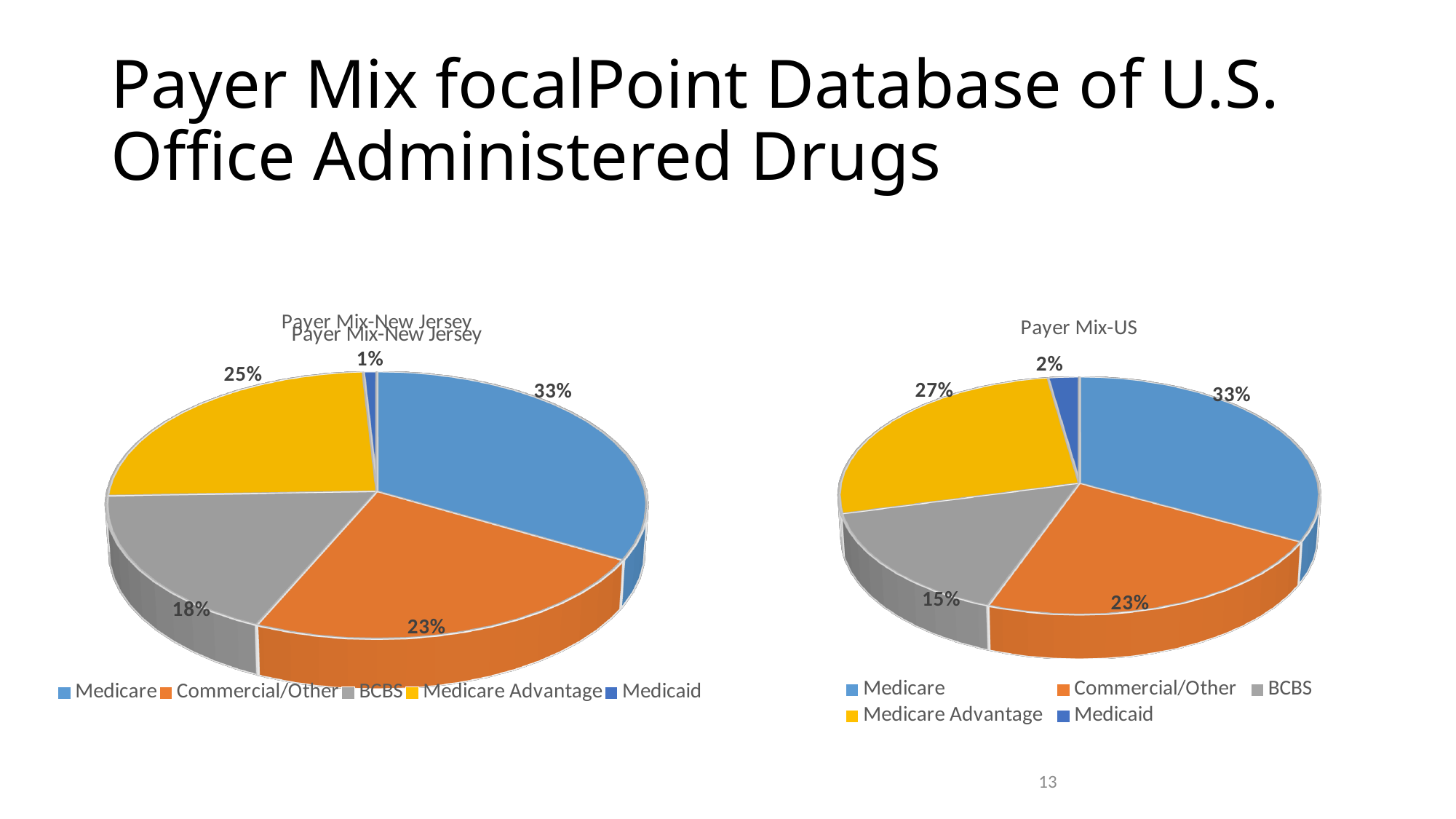
In the Payer Mix-New Jersey chart, what is the combined share of Medicare and Commercial/Other? 56% What is the difference between the BCBS share in the Payer Mix-New Jersey chart and the BCBS share in the Payer Mix-US chart? 3% In the Payer Mix-New Jersey chart, which payer has the largest share? Medicare What kind of chart is the Payer Mix-US chart? Pie chart In the Payer Mix-US chart, which is larger: the Commercial/Other share or the Medicare Advantage share? Medicare Advantage In the Payer Mix-New Jersey chart, what share does BCBS have? 18% In the Payer Mix-US chart, what share does Medicare Advantage have? 27% How many slices does the Payer Mix-New Jersey chart have? 5 In the Payer Mix-US chart, which payer has the smallest share? Medicaid In the Payer Mix-New Jersey chart, what share does Medicare have? 33% In the Payer Mix-US chart, which colour represents Medicare Advantage? Yellow In the Payer Mix-US chart, what share does Medicaid have? 2%